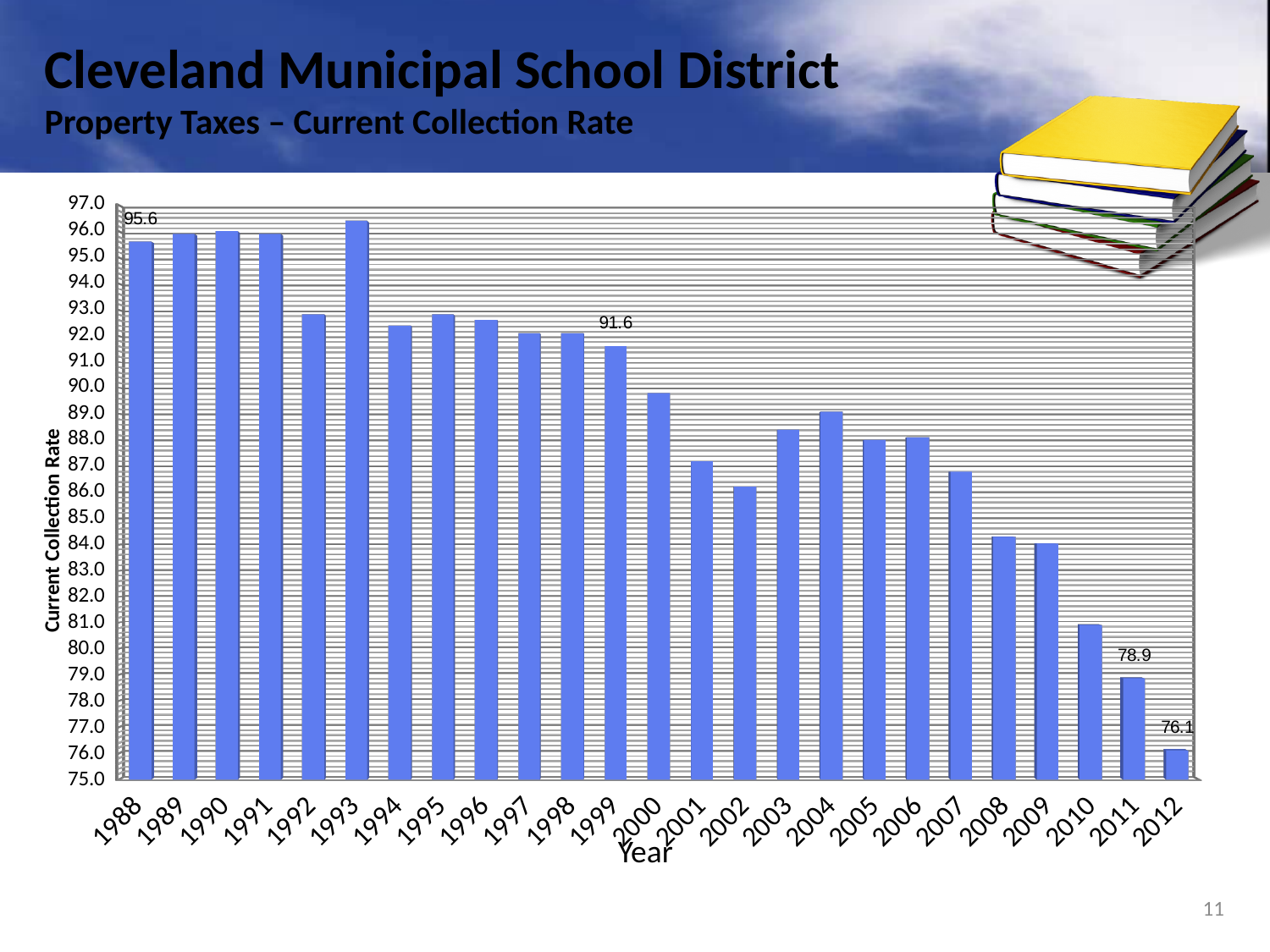
What is the difference between the collection rates for 1988 and 2012? 19.5 What is the current collection rate for 2012? 76.1 What is the current collection rate for 2011? 78.9 What is the current collection rate for 1999? 91.6 What is the current collection rate for 1988? 95.6 How many years are shown on the x axis? 25 Which year has the lowest current collection rate? 2012 What is the difference between the collection rates for 2011 and 2012? 2.8 Which year has a higher collection rate, 1988 or 1999? 1988 Is the value for 2010 greater or less than 80.0? greater Do the collection rates generally rise or fall from 1988 to 2012? fall Which year has the highest current collection rate? 1993